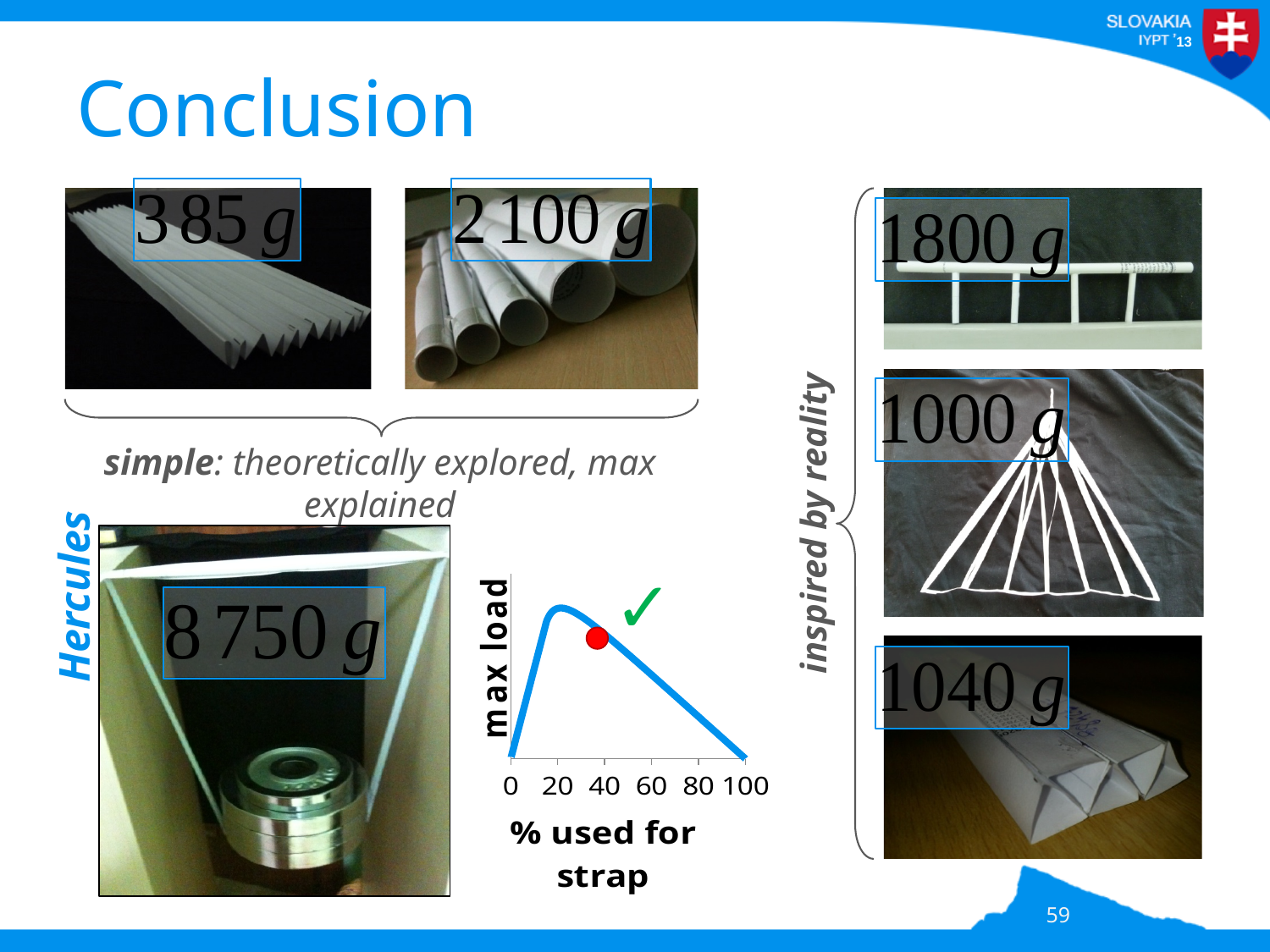
What kind of chart is shown on the slide? line chart Is the max load at 20% used for strap greater or less than the max load at 100% used for strap? greater How many tick values are printed on the x axis of the chart? 6 What is the label of the y axis of the chart? max load Does max load rise or fall as % used for strap increases from 40 to 100? fall How many lines are plotted on the chart? 1 Is the % used for strap at the peak of the curve greater or less than 40? less Is the % used for strap at the red dot greater or less than 60? less What is the highest tick value printed on the x axis of the chart? 100 Does max load rise or fall as % used for strap increases from 0 to 20? rise What is the label of the x axis of the chart? % used for strap Is the % used for strap at the red dot greater or less than 20? greater